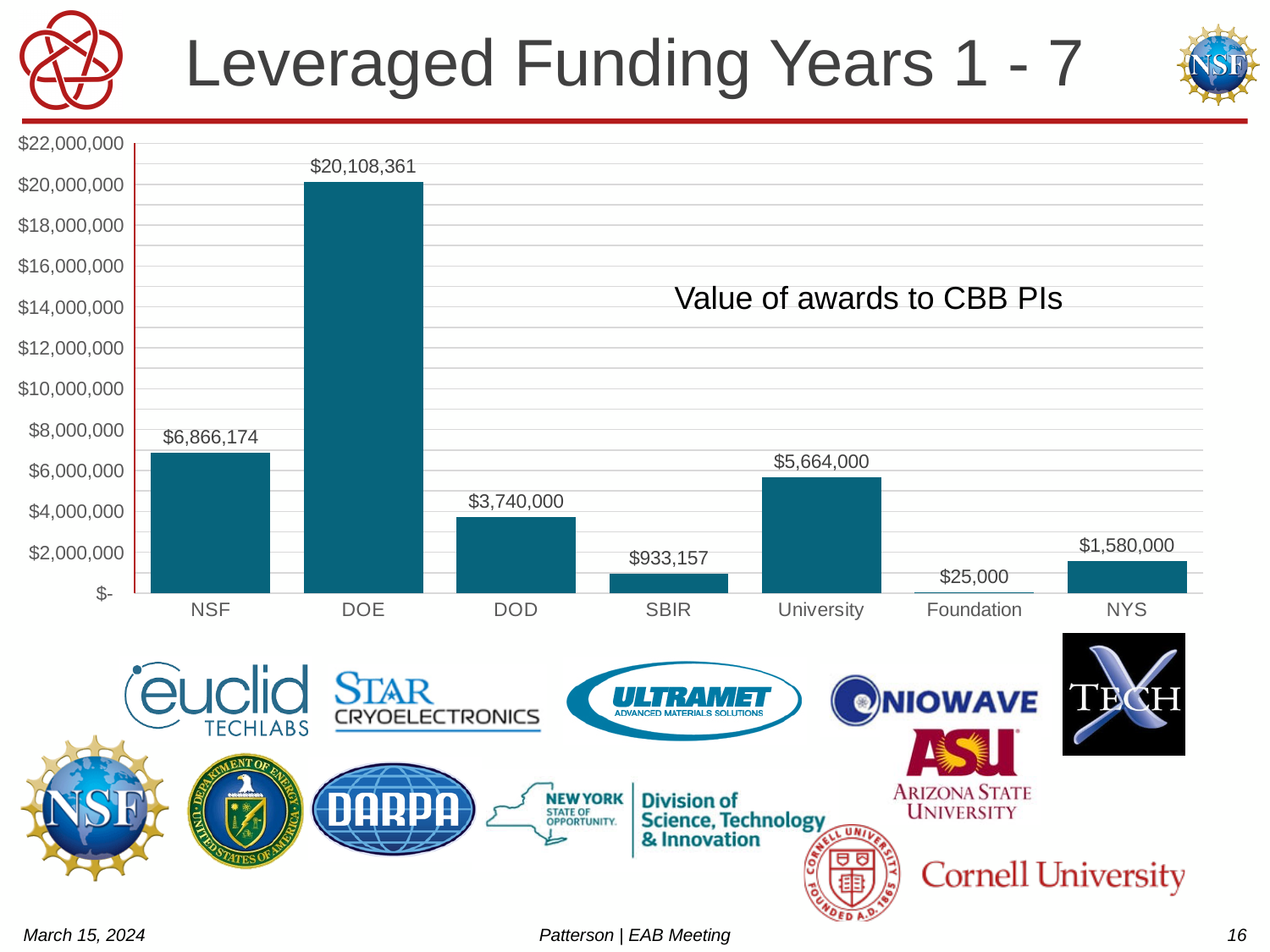
Which category has the highest value? DOE Which is larger, the value for University or the value for DOD? University What is the value for NSF? $6,866,174 How many categories are shown on the x axis? 7 What is the difference between the values for DOD and NYS? $2,160,000 What is the value for SBIR? $933,157 What is the difference between the values for NSF and University? $1,202,174 What kind of chart is shown on the slide? bar chart Is the value for NYS greater or less than $2,000,000? less Which category has the lowest value? Foundation What is the value for DOE? $20,108,361 What is the value for Foundation? $25,000